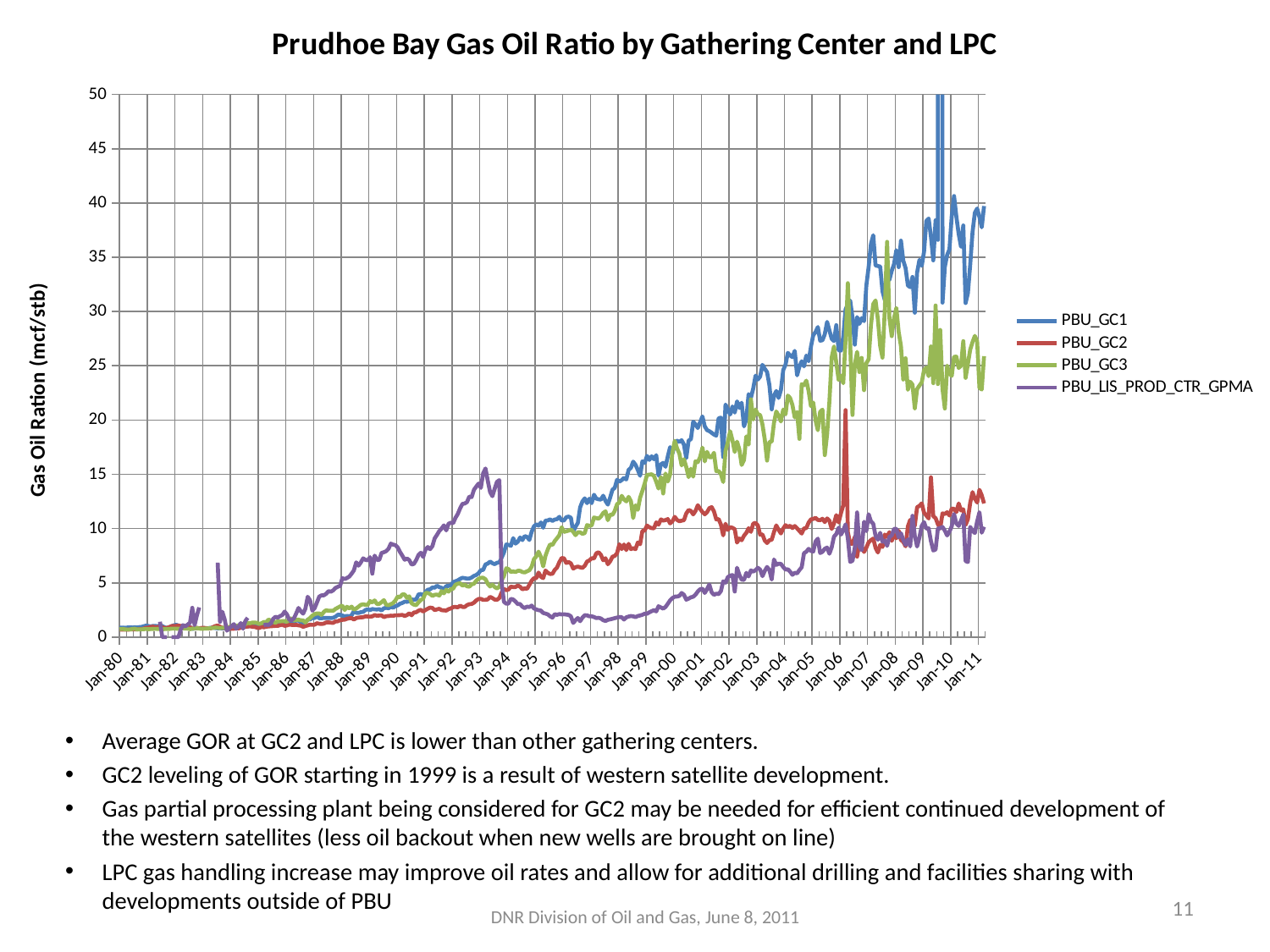
How many series does the legend list? 4 At Jan-93, which is larger: PBU_LIS_PROD_CTR_GPMA or PBU_GC1? PBU_LIS_PROD_CTR_GPMA What kind of chart is shown on the slide? line chart Is the value of PBU_GC2 at Jan-11 greater or less than 20? less Does the PBU_GC1 series generally rise or fall from Jan-80 to Jan-11? rise Is the value of PBU_GC1 at Jan-11 greater or less than 35? greater Is the value of PBU_LIS_PROD_CTR_GPMA at Jan-96 greater or less than 5? less At Jan-11, which is larger: PBU_GC1 or PBU_GC3? PBU_GC1 Which colour is used for the PBU_GC2 series? red Which series has the highest value at Jan-11? PBU_GC1 What is the title of the chart? Prudhoe Bay Gas Oil Ratio by Gathering Center and LPC Which series goes above the top of the y axis (50) around Jan-10? PBU_GC1